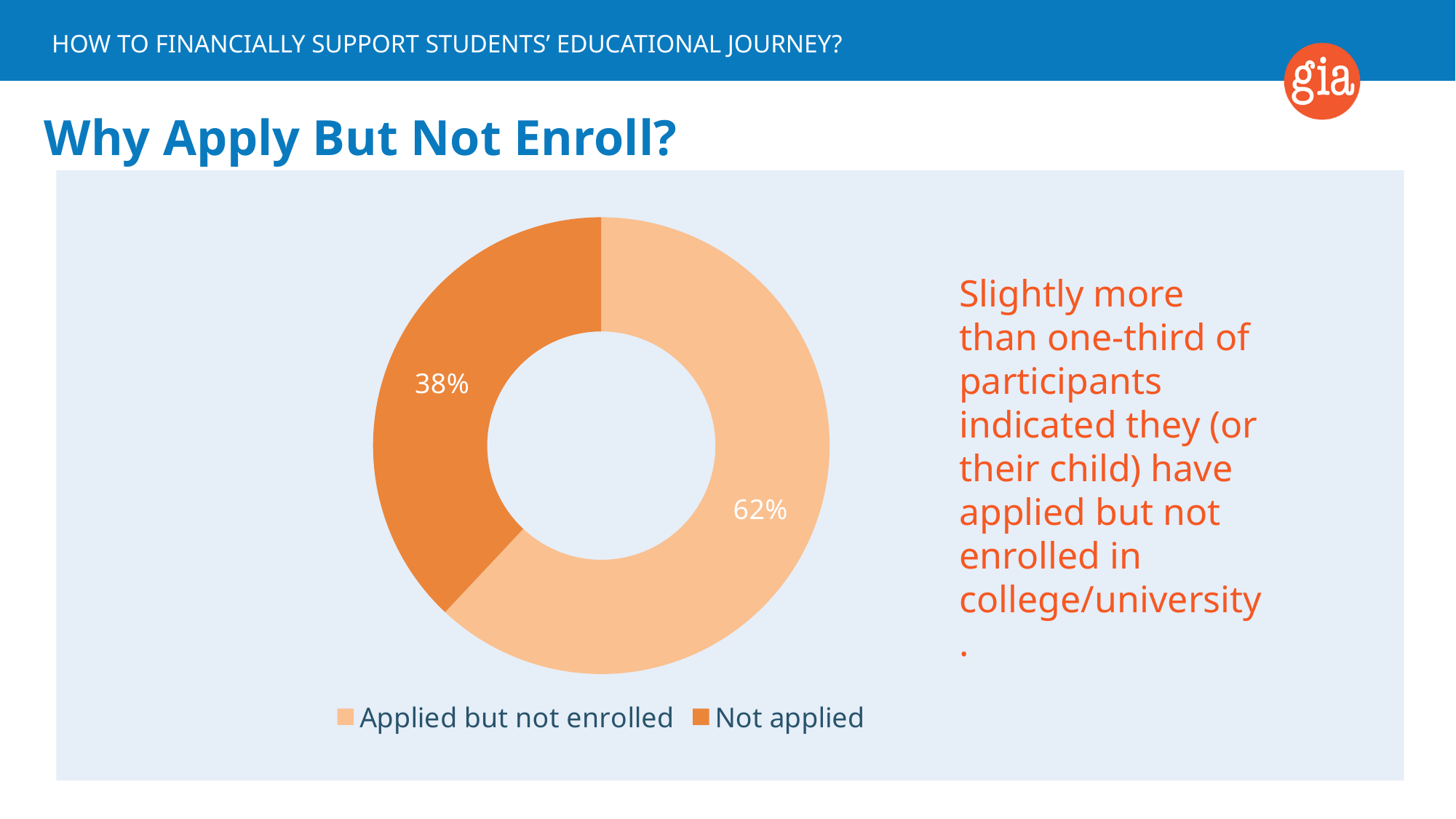
What is the title of the slide containing the chart? Why Apply But Not Enroll? What is the difference in percentage points between "Applied but not enrolled" and "Not applied"? 24 How many entries does the legend list? 2 What percentage of the chart is labelled "Applied but not enrolled"? 62% How many categories does the chart show? 2 Which category has the largest share of the chart? Applied but not enrolled What colour is the "Not applied" slice? Dark orange Which category has the smallest share of the chart? Not applied What percentage of the chart is labelled "Not applied"? 38% What share of the chart does the "Not applied" slice take? 38% What kind of chart is shown on the slide? Doughnut (pie) chart Which is larger: the share for "Applied but not enrolled" or the share for "Not applied"? Applied but not enrolled